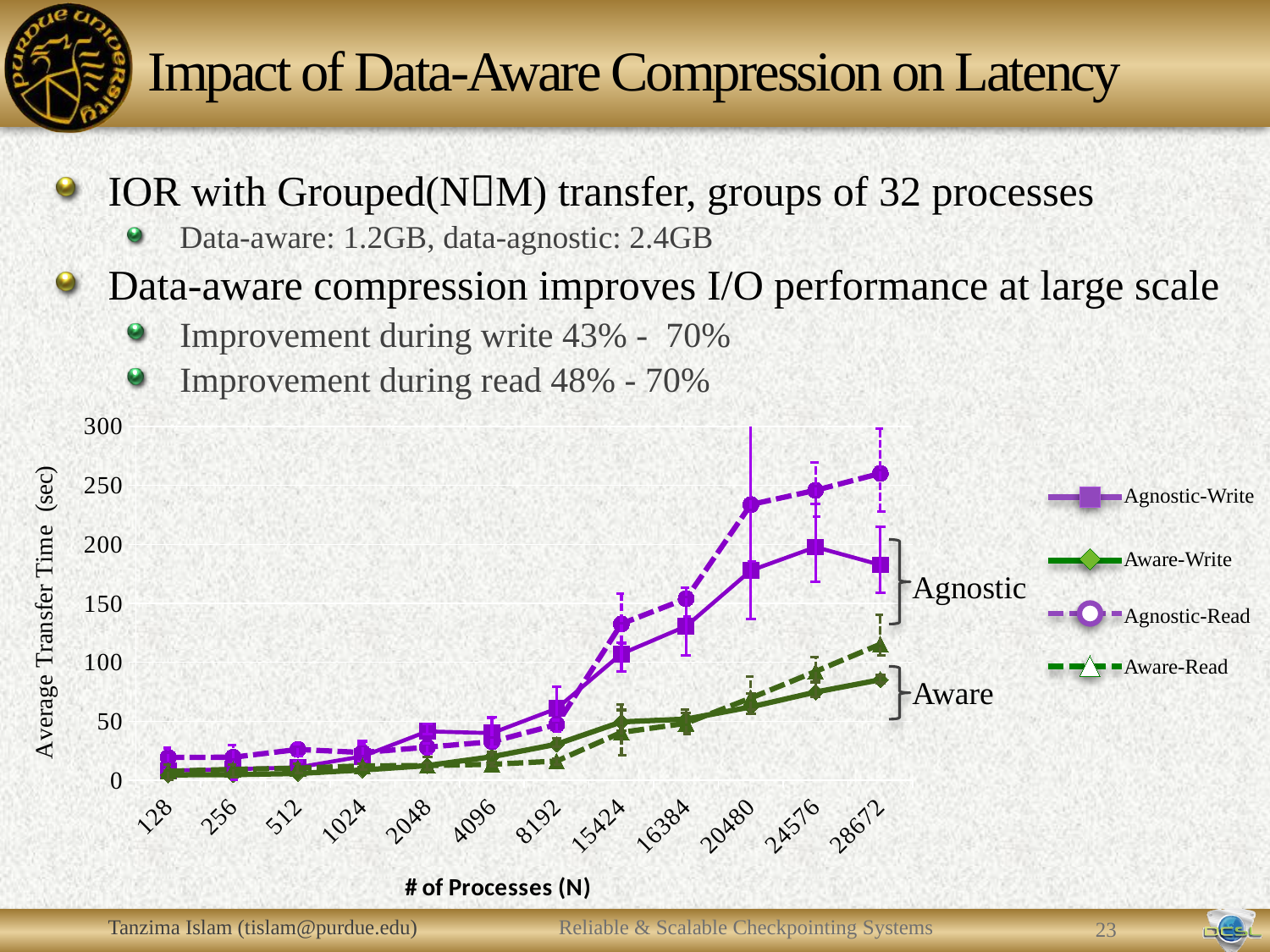
At 28672 processes, which is larger: the Agnostic-Read value or the Aware-Read value? Agnostic-Read What kind of chart is shown on the slide? line chart Is the Agnostic-Read value at 28672 processes greater or less than 200? greater What is the title of the chart's x axis? # of Processes (N) What is the title of the chart's y axis? Average Transfer Time (sec) Does the Agnostic-Read series rise or fall as the number of processes increases? rise How many series does the chart's legend list? 4 How many process counts (N) are plotted along the x axis? 12 Is the Aware-Write value at 28672 processes greater or less than 100? less At 15424 processes, which is larger: the Agnostic-Write value or the Aware-Write value? Agnostic-Write Which series has the highest average transfer time at 28672 processes? Agnostic-Read Is the Agnostic-Read value at 20480 processes greater or less than 200? greater